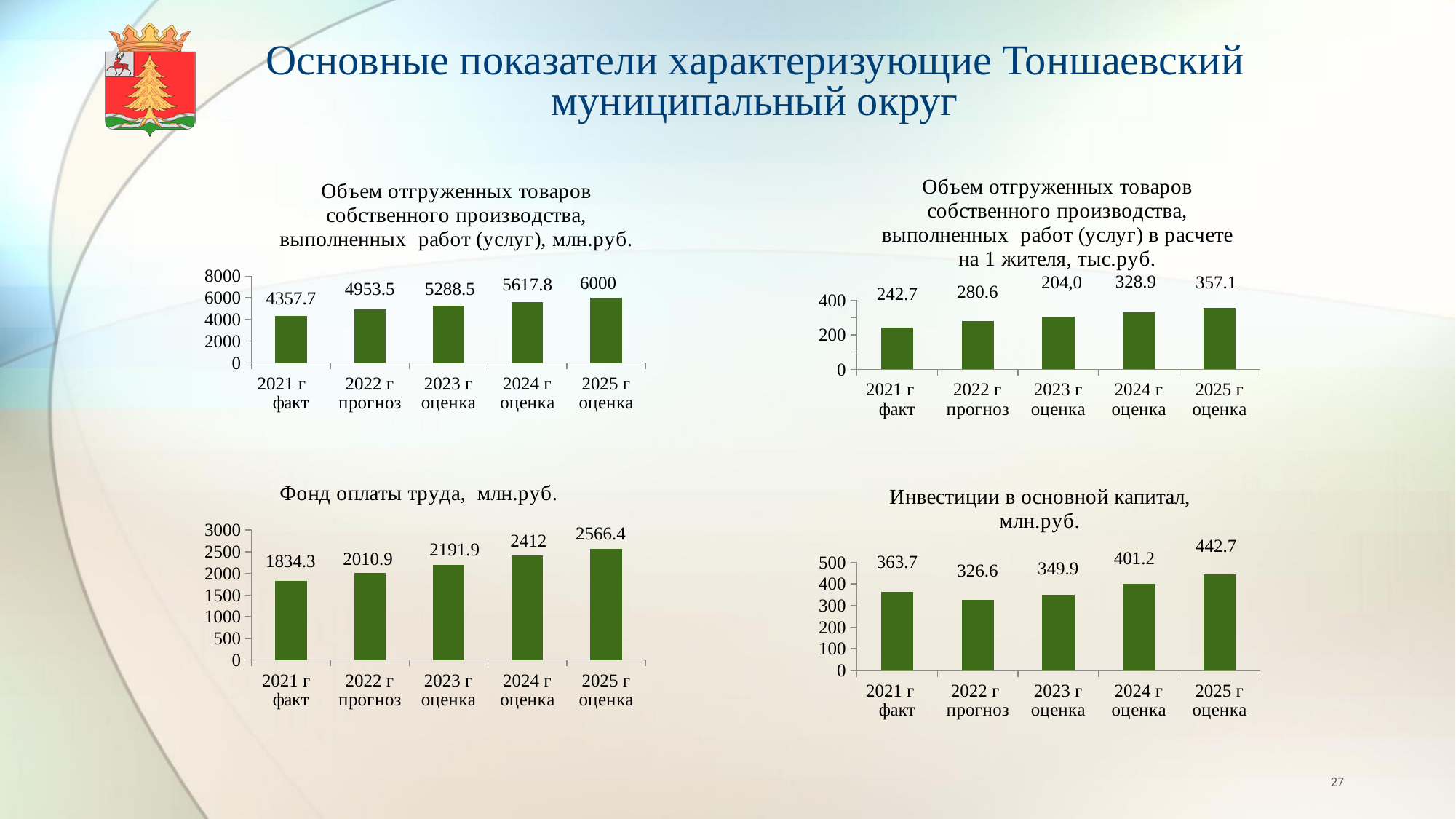
On the bottom-right chart (Инвестиции в основной капитал), what is the value for 2022 г прогноз? 326.6 On the top-right chart (в расчете на 1 жителя, тыс.руб.), what is the value for 2022 г прогноз? 280.6 On the bottom-right chart (Инвестиции в основной капитал), which is larger: the value for 2021 г факт or 2023 г оценка? 2021 г факт On the bottom-left chart (Фонд оплаты труда), do the values rise or fall from 2021 to 2025? rise On the top-left chart (Объем отгруженных товаров ... млн.руб.), what is the difference between the 2025 г оценка and 2021 г факт values? 1642.3 On the bottom-right chart (Инвестиции в основной капитал), how many bars are plotted? 5 On the top-left chart (Объем отгруженных товаров ... млн.руб.), what is the value for 2025 г оценка? 6000 On the top-right chart (в расчете на 1 жителя, тыс.руб.), which year has the highest value? 2025 г оценка On the bottom-left chart (Фонд оплаты труда), which year has the lowest value? 2021 г факт On the bottom-left chart (Фонд оплаты труда), what is the value for 2024 г оценка? 2412 On the top-left chart (Объем отгруженных товаров ... млн.руб.), what is the value for 2021 г факт? 4357.7 What type of chart is the bottom-left chart (Фонд оплаты труда)? bar chart